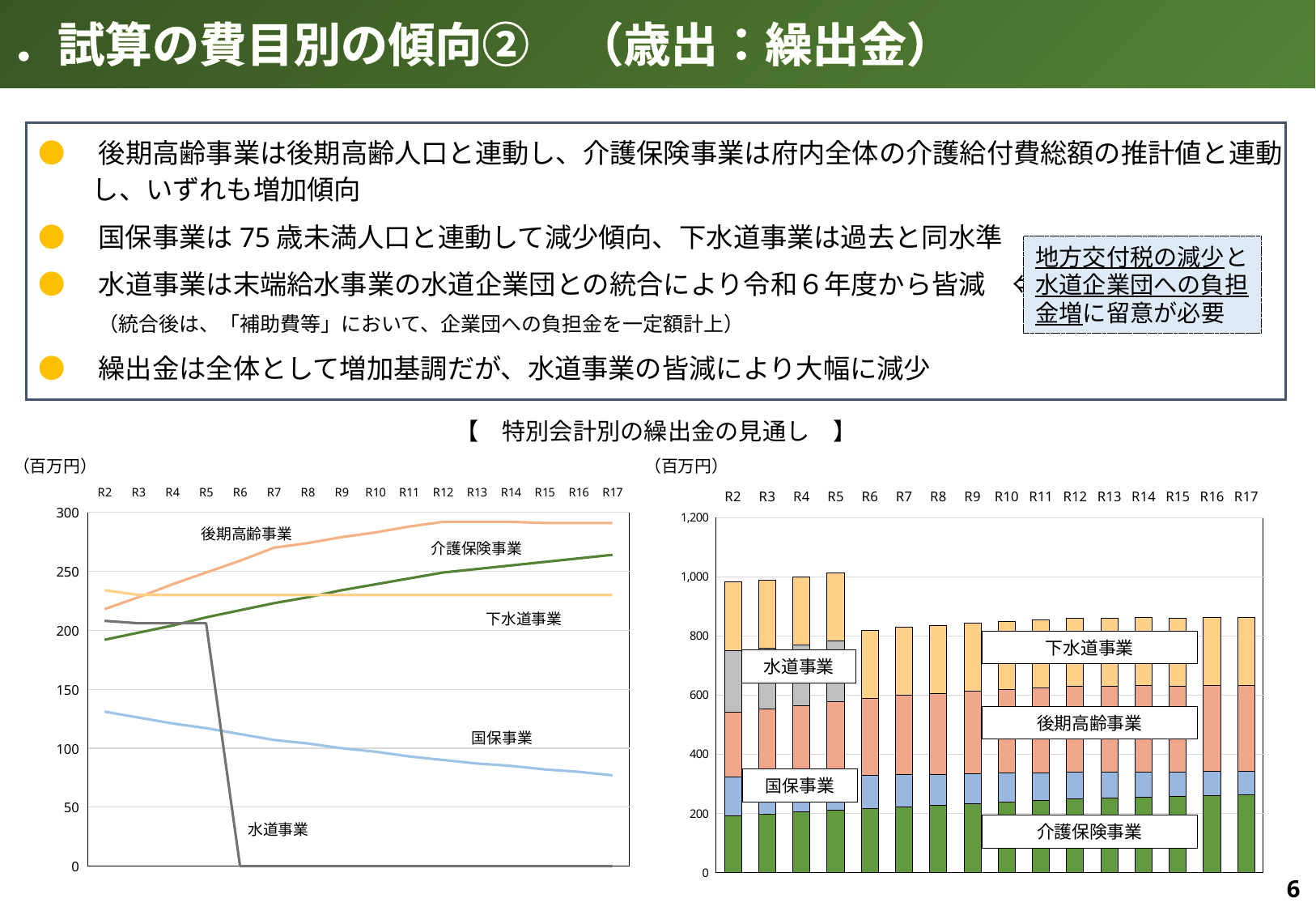
What kind of chart is the right chart on the slide? stacked bar chart In the left chart, how many series are labelled? 5 In the left chart, at R2, which is larger: 水道事業 or 国保事業? 水道事業 In the right chart, is the total of the stacked bar for R6 greater or less than 1,000? less In the left chart, how many fiscal years (R2 to R17) are plotted along the x axis? 16 In the left chart, is the value for 国保事業 at R17 greater or less than 100? less In the left chart, is the value for 後期高齢事業 at R17 greater or less than 250? greater In the left chart, which series is lowest at R17? 水道事業 In the left chart, which series is highest at R17? 後期高齢事業 In the left chart, does 国保事業 rise or fall from R2 to R17? fall What kind of chart is the left chart on the slide? line chart In the right chart, how many stacked bars are there? 16